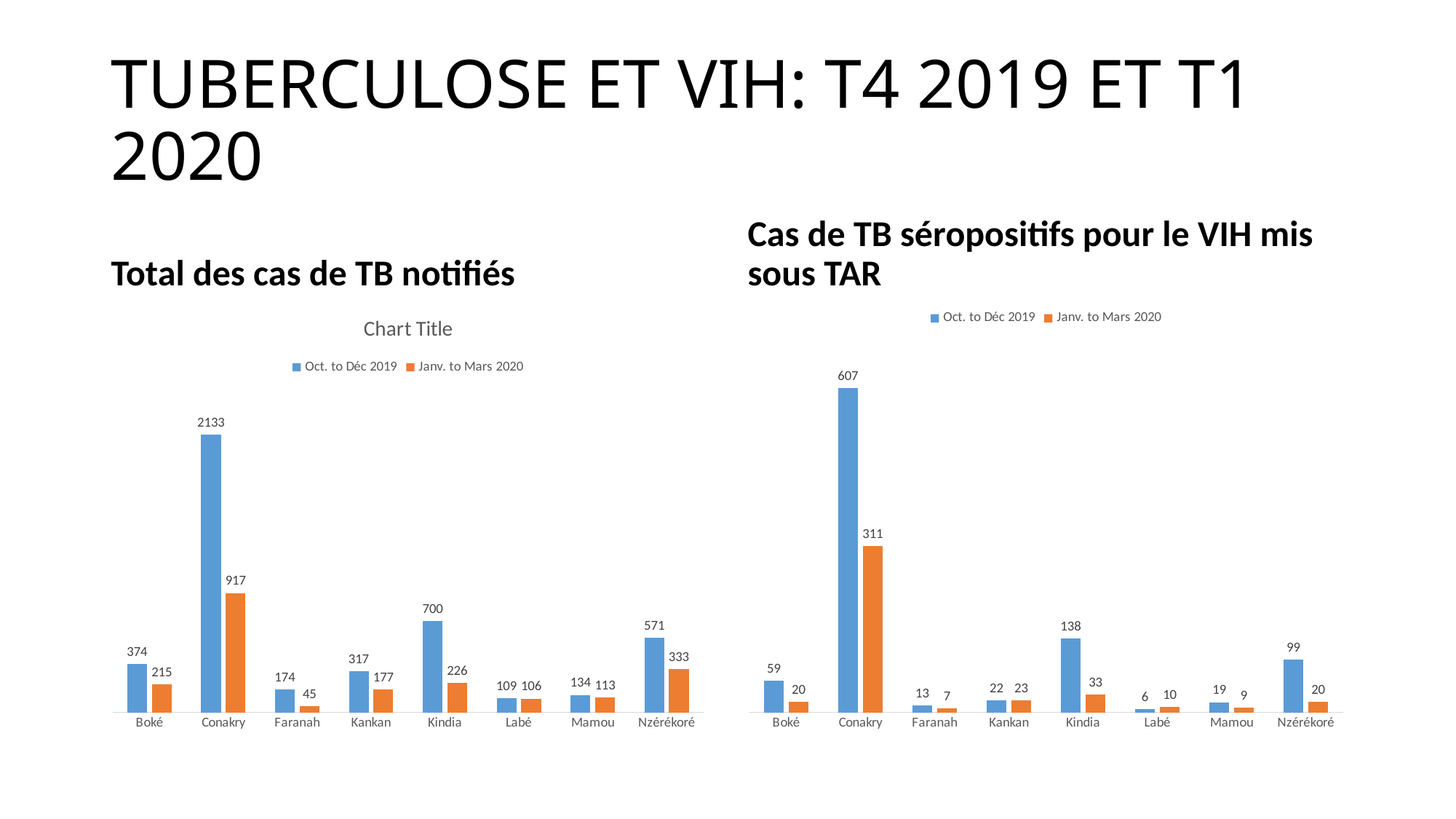
In the 'Total des cas de TB notifiés' chart, which region has the highest value for Oct. to Déc 2019? Conakry In the 'Cas de TB séropositifs pour le VIH mis sous TAR' chart, which region has the lowest value for Oct. to Déc 2019? Labé How many series does the legend of the 'Cas de TB séropositifs pour le VIH mis sous TAR' chart list? 2 In the 'Cas de TB séropositifs pour le VIH mis sous TAR' chart, what is the value for Kindia in Oct. to Déc 2019? 138 In the 'Total des cas de TB notifiés' chart, what is the value for Conakry in Oct. to Déc 2019? 2133 In the 'Total des cas de TB notifiés' chart, what is the difference between the Oct. to Déc 2019 and Janv. to Mars 2020 values for Nzérékoré? 238 In the 'Total des cas de TB notifiés' chart, what is the value for Kindia in Janv. to Mars 2020? 226 In the 'Cas de TB séropositifs pour le VIH mis sous TAR' chart, what is the value for Labé in Janv. to Mars 2020? 10 In the 'Cas de TB séropositifs pour le VIH mis sous TAR' chart, which is larger for Kankan: Oct. to Déc 2019 or Janv. to Mars 2020? Janv. to Mars 2020 What type of chart is the 'Total des cas de TB notifiés' chart? Bar chart How many regions are shown on the x axis of the 'Total des cas de TB notifiés' chart? 8 In the 'Cas de TB séropositifs pour le VIH mis sous TAR' chart, what is the difference between the Oct. to Déc 2019 and Janv. to Mars 2020 values for Conakry? 296